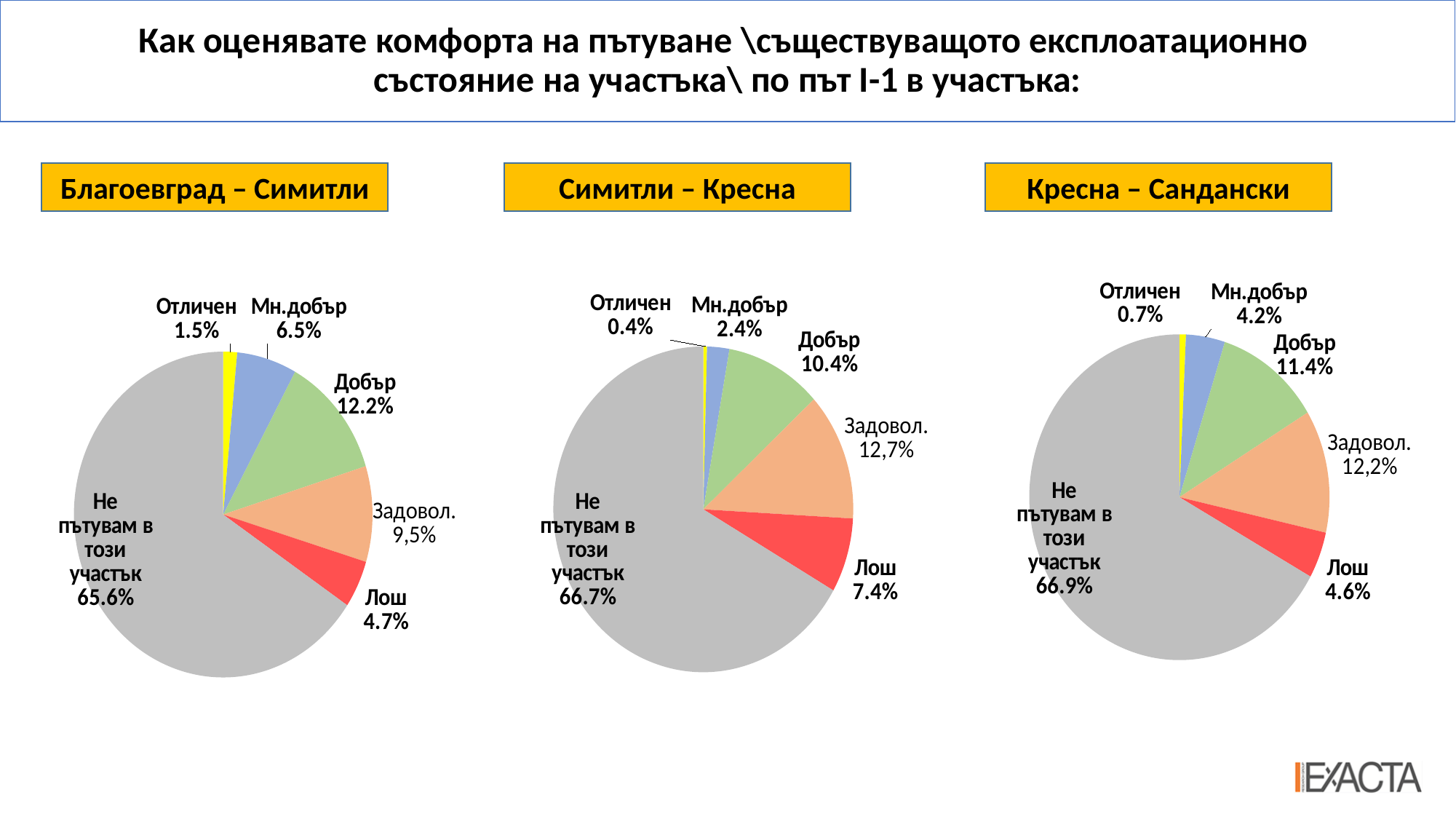
What type of chart is used for "Кресна – Сандански"? Pie chart In the "Благоевград – Симитли" chart, what share is labelled for "Добър"? 12.2% In the "Кресна – Сандански" chart, what is the difference between the "Добър" and "Лош" shares? 6.8% In the "Кресна – Сандански" chart, what share is labelled for "Мн.добър"? 4.2% In the "Кресна – Сандански" chart, what share is labelled for "Не пътувам в този участък"? 66.9% In the "Симитли – Кресна" chart, which category has the smallest slice? Отличен How many pie charts are shown on the slide? 3 How many slices does the "Симитли – Кресна" pie chart have? 6 In the "Симитли – Кресна" chart, what share is labelled for "Задовол."? 12,7% In the "Симитли – Кресна" chart, what share is labelled for "Лош"? 7.4% In the "Благоевград – Симитли" chart, which is larger: "Мн.добър" or "Лош"? Мн.добър In the "Благоевград – Симитли" chart, which category has the largest slice? Не пътувам в този участък